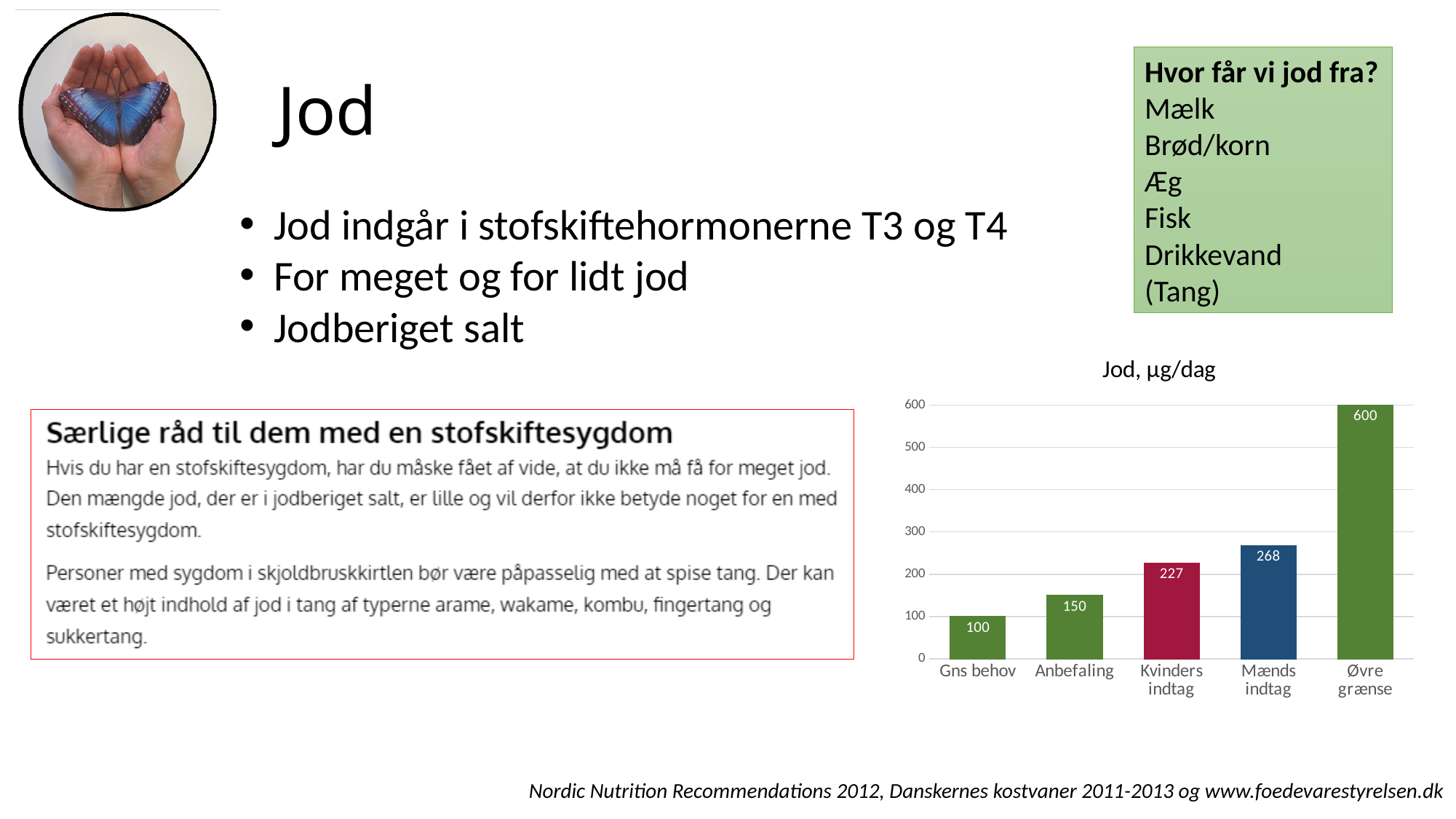
What is the value for Mænds indtag in the chart? 268 How many categories are shown in the chart? 5 Which category has the lowest value in the chart? Gns behov Which is larger, Anbefaling or Kvinders indtag? Kvinders indtag What is the difference between Øvre grænse and Anbefaling? 450 What is the value for Gns behov in the chart? 100 What is the title of the chart? Jod, µg/dag What is the difference between Mænds indtag and Kvinders indtag? 41 What kind of chart is shown on the slide? bar chart Is the value for Mænds indtag greater or less than 300? less What is the value for Kvinders indtag in the chart? 227 Which category has the highest value in the chart? Øvre grænse